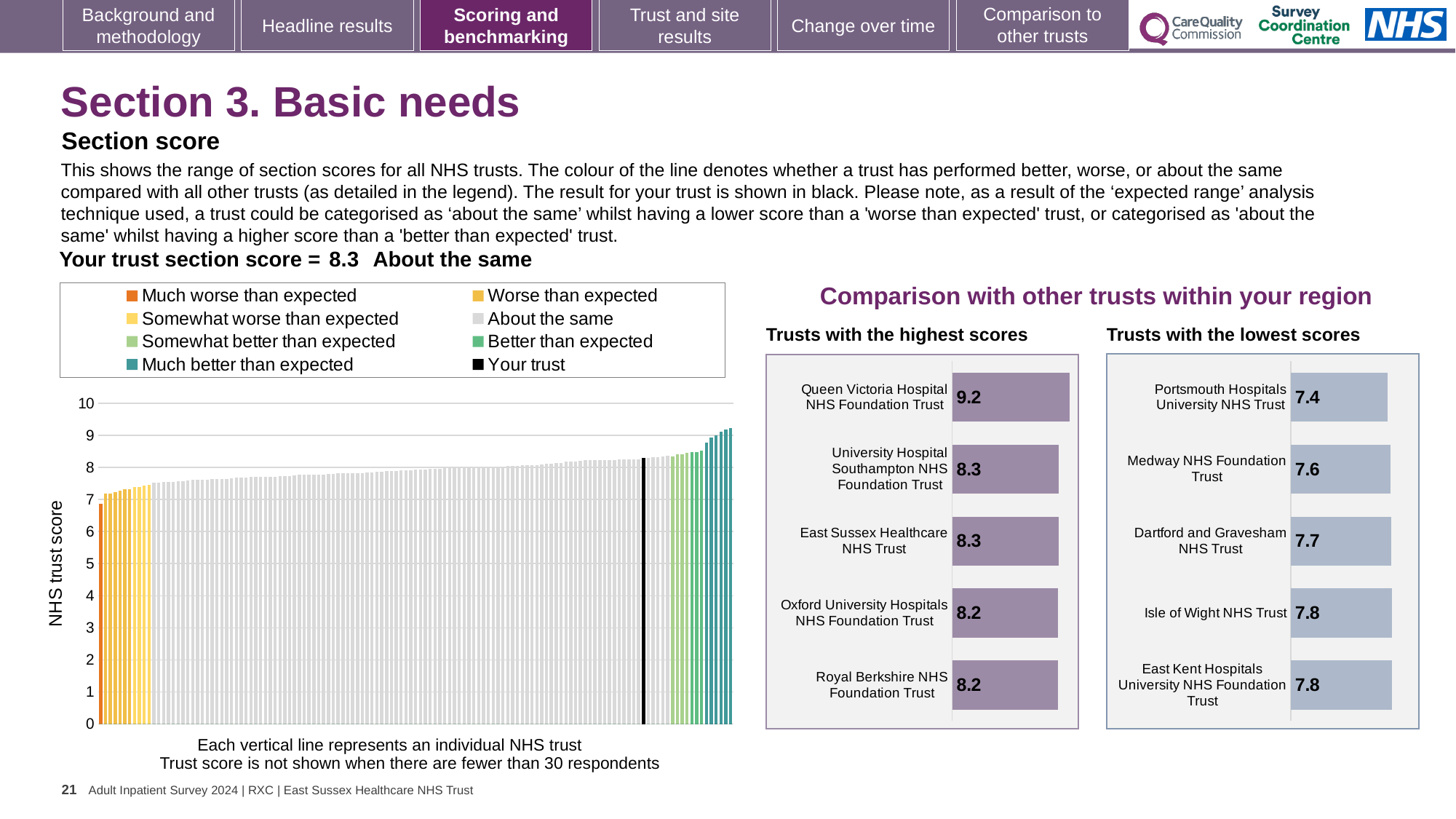
In the 'Trusts with the lowest scores' chart, what is the difference between the scores of Isle of Wight NHS Trust and Portsmouth Hospitals University NHS Trust? 0.4 How many trusts are shown in the 'Trusts with the highest scores' chart? 5 In the 'Trusts with the highest scores' chart, what is the difference between the scores of Queen Victoria Hospital NHS Foundation Trust and Royal Berkshire NHS Foundation Trust? 1.0 How many entries does the legend of the left-hand chart list? 8 In the 'Trusts with the highest scores' chart, which trust has the highest score? Queen Victoria Hospital NHS Foundation Trust What kind of chart is the large chart on the left showing NHS trust scores? Bar chart In the 'Trusts with the lowest scores' chart, what is the score for Portsmouth Hospitals University NHS Trust? 7.4 What is the label on the vertical axis of the left-hand chart? NHS trust score In the 'Trusts with the highest scores' chart, what is the score for Queen Victoria Hospital NHS Foundation Trust? 9.2 In the 'Trusts with the lowest scores' chart, which trust has the lowest score? Portsmouth Hospitals University NHS Trust In the left-hand chart, do the trust scores rise or fall from left to right? Rise In the 'Trusts with the lowest scores' chart, which has the higher score: Medway NHS Foundation Trust or Dartford and Gravesham NHS Trust? Dartford and Gravesham NHS Trust